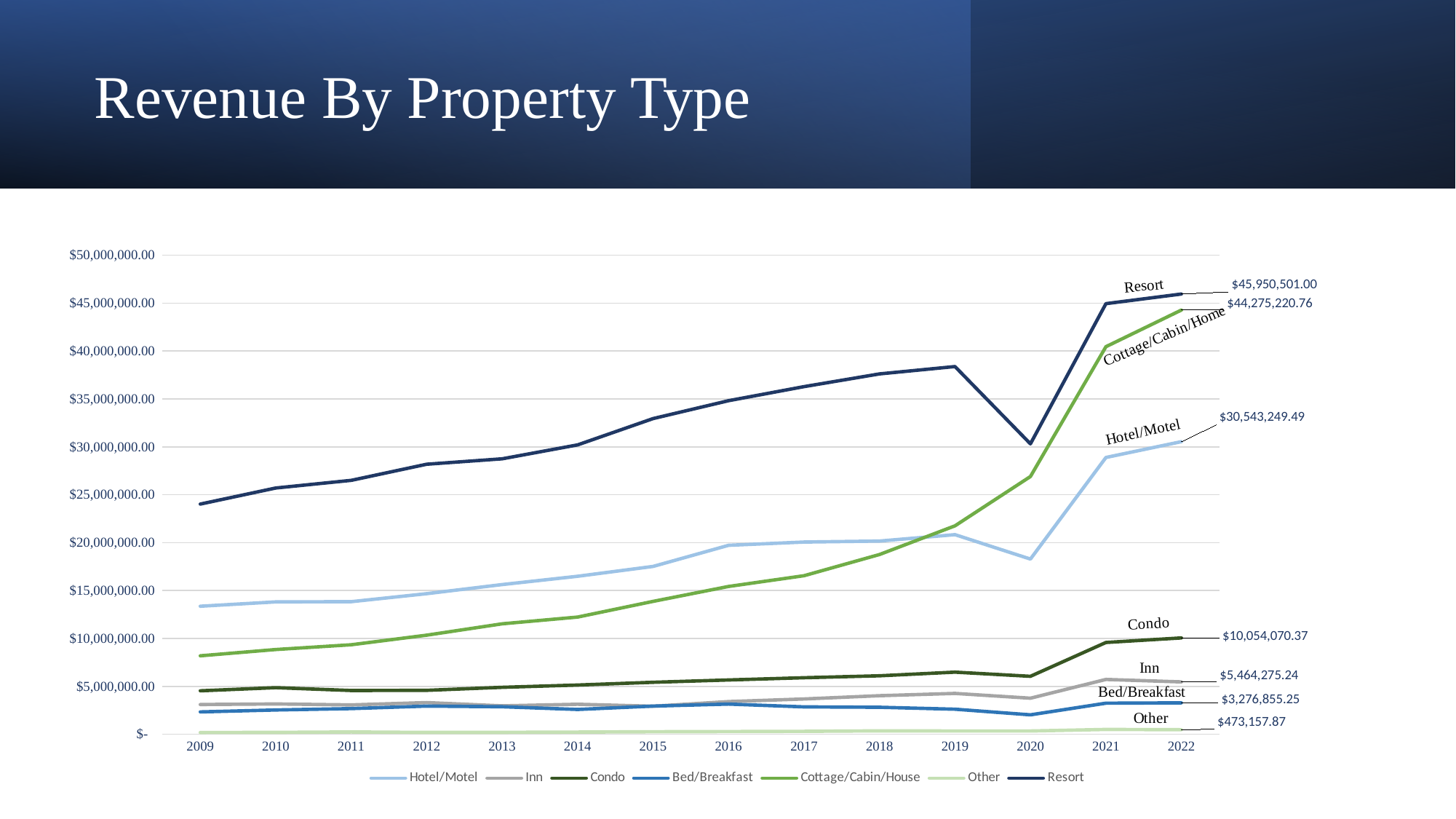
What is the 2022 revenue for Other? $473,157.87 What is the 2022 revenue for Resort? $45,950,501.00 How many series does the legend list? 7 How many years are shown on the x axis? 14 Which property type has the lowest revenue in 2022? Other Does the Cottage/Cabin/House revenue generally rise or fall from 2009 to 2022? rise What is the 2022 revenue for Cottage/Cabin/House? $44,275,220.76 Which property type has the highest revenue in 2022? Resort What is the difference between the 2022 revenue for Condo and Inn? $4,589,795.13 Is the Resort revenue in 2020 greater or less than $35,000,000.00? less What type of chart is shown on the slide? Line chart What is the 2022 revenue for Hotel/Motel? $30,543,249.49